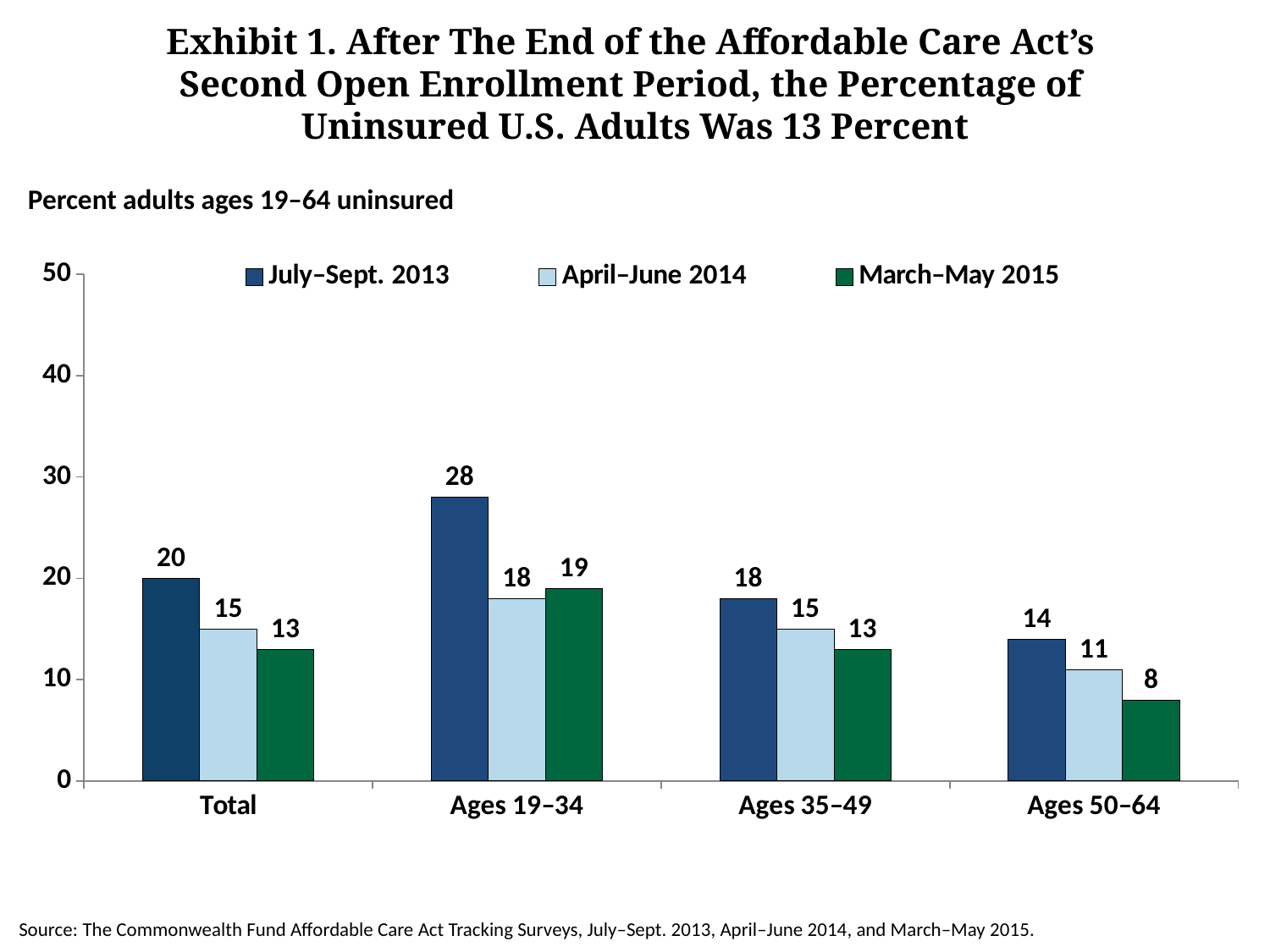
What is the value for Ages 19–34 in the July–Sept. 2013 series? 28 Which category has the highest value in the July–Sept. 2013 series? Ages 19–34 What is the value for Total in the March–May 2015 series? 13 How many series does the legend list? 3 What kind of chart is shown on the slide? bar chart Which category has the lowest value in the March–May 2015 series? Ages 50–64 Which is larger for Ages 19–34: the April–June 2014 value or the March–May 2015 value? March–May 2015 How many categories are shown on the x axis? 4 What is the difference between the July–Sept. 2013 and March–May 2015 values for Ages 35–49? 5 Across the three survey periods, do the values for Ages 50–64 rise or fall? fall What is the value for Ages 50–64 in the April–June 2014 series? 11 Is the value for Ages 19–34 in the July–Sept. 2013 series greater or less than 20? greater